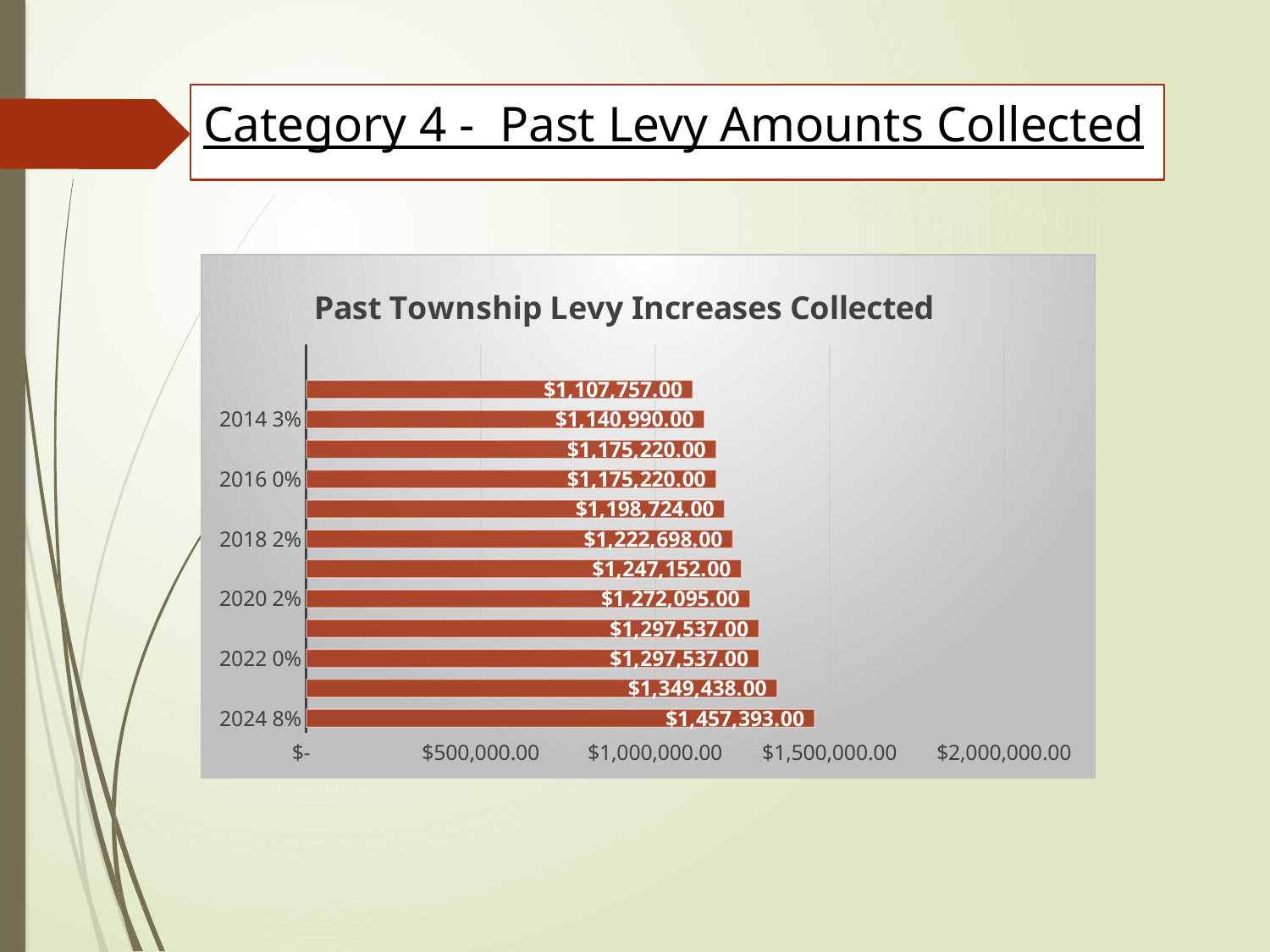
What kind of chart is shown? bar chart What is the value for 2022 0%? $1,297,537.00 What is the value for 2014 3%? $1,140,990.00 Which is larger, the value for 2020 2% or the value for 2016 0%? 2020 2% What is the value for 2018 2%? $1,222,698.00 What is the difference between the values for 2024 8% and 2022 0%? $159,856.00 How many bars are plotted in the chart? 12 What is the value for 2016 0%? $1,175,220.00 What is the value for 2020 2%? $1,272,095.00 Which category has the highest value? 2024 8% Is the value for 2014 3% greater or less than $1,500,000.00? less What is the value for 2024 8%? $1,457,393.00